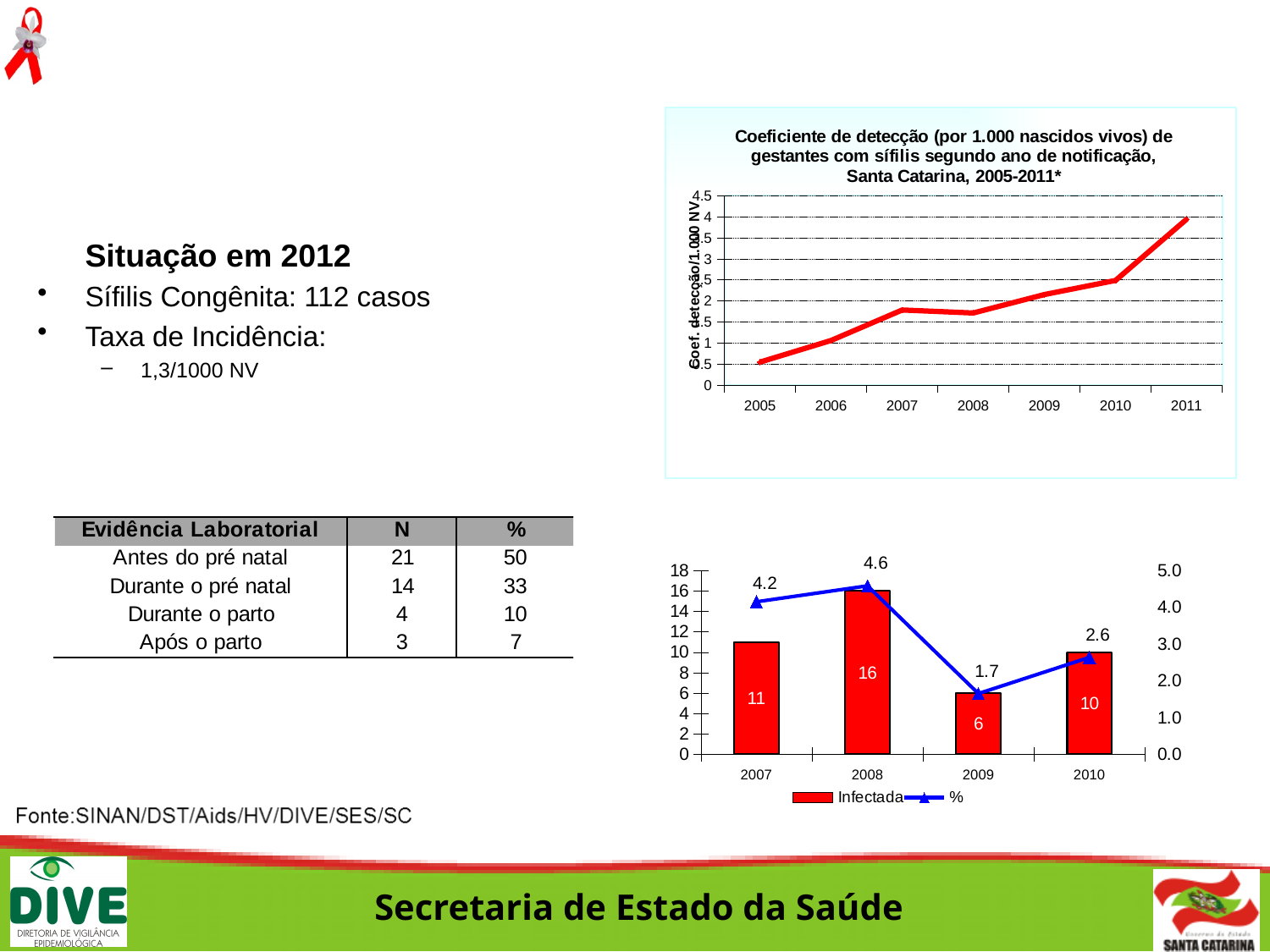
In the chart titled 'Coeficiente de detecção (por 1.000 nascidos vivos) de gestantes com sífilis', which year has the highest value? 2011 In the bottom-right chart, is the % value for 2007 larger or smaller than the % value for 2010? larger In the chart titled 'Coeficiente de detecção (por 1.000 nascidos vivos) de gestantes com sífilis', do the values generally rise or fall from 2005 to 2011? rise In the bottom-right chart, what is the Infectada value for 2010? 10 In the bottom-right chart, what is the % value for 2009? 1.7 In the bottom-right chart, what is the Infectada value for 2008? 16 How many years are shown on the x axis of the chart titled 'Coeficiente de detecção (por 1.000 nascidos vivos) de gestantes com sífilis'? 7 In the bottom-right chart, which year has the highest Infectada value? 2008 In the chart titled 'Coeficiente de detecção (por 1.000 nascidos vivos) de gestantes com sífilis', is the value for 2005 greater or less than 1? less In the bottom-right chart, which year has the lowest % value? 2009 In the bottom-right chart, what is the difference between the Infectada values for 2008 and 2009? 10 How many series does the legend of the bottom-right chart list? 2